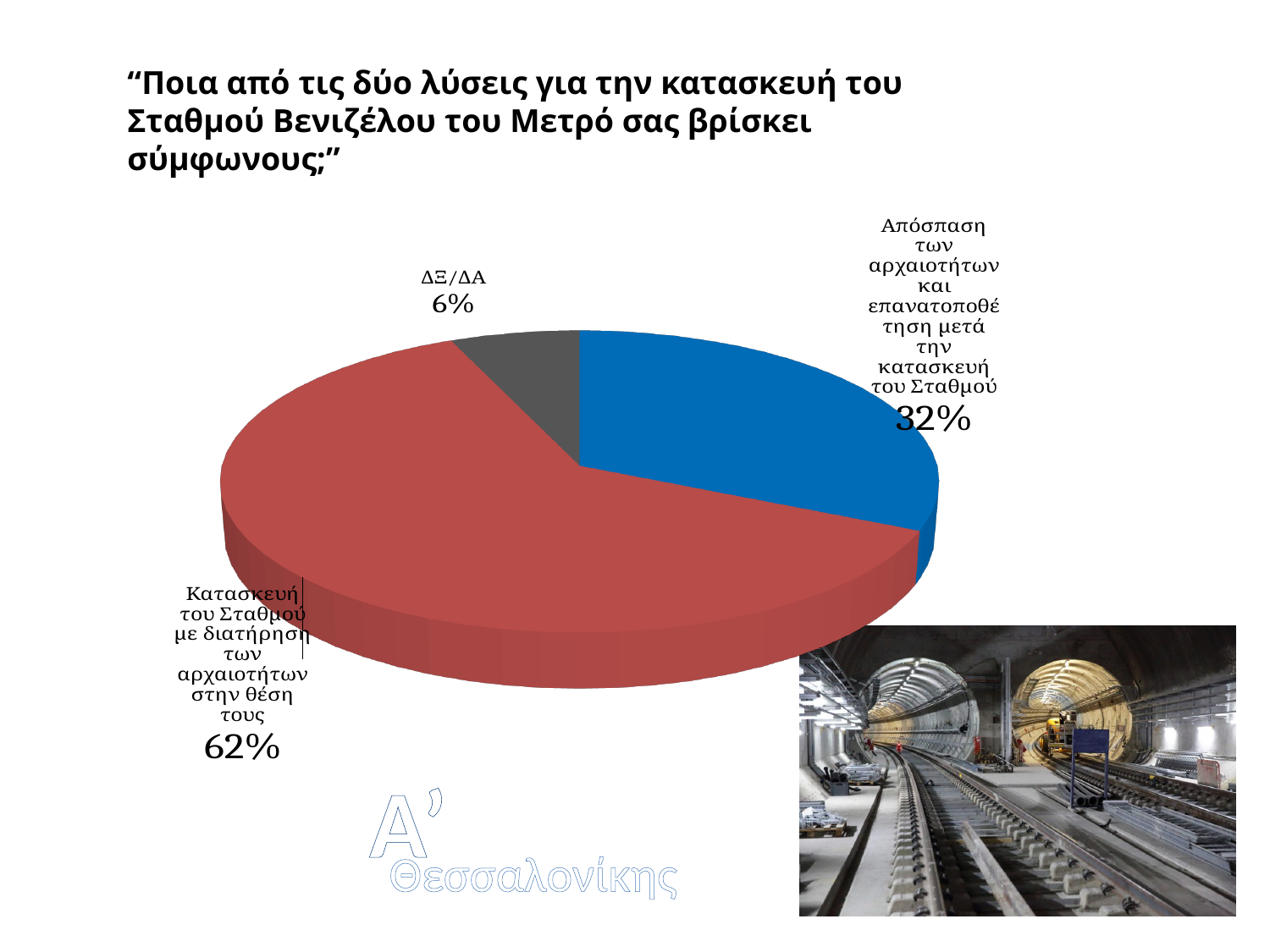
What is the difference in percentage points between the "Κατασκευή του Σταθμού με διατήρηση των αρχαιοτήτων στην θέση τους" slice and the "Απόσπαση των αρχαιοτήτων και επανατοποθέτηση μετά την κατασκευή του Σταθμού" slice? 30 Which slice of the pie chart is the smallest? ΔΞ/ΔΑ What kind of chart is shown on the slide? Pie chart What share of the pie is labelled "Κατασκευή του Σταθμού με διατήρηση των αρχαιοτήτων στην θέση τους"? 62% Which slice of the pie chart is the largest? Κατασκευή του Σταθμού με διατήρηση των αρχαιοτήτων στην θέση τους What colour is the "ΔΞ/ΔΑ" slice? Grey What share of the pie is labelled "Απόσπαση των αρχαιοτήτων και επανατοποθέτηση μετά την κατασκευή του Σταθμού"? 32% How many slices does the pie chart have? 3 What is the difference in percentage points between the "Απόσπαση των αρχαιοτήτων" slice and the "ΔΞ/ΔΑ" slice? 26 Which is larger: the "Απόσπαση των αρχαιοτήτων" slice or the "ΔΞ/ΔΑ" slice? Απόσπαση των αρχαιοτήτων What percentage is shown for the "ΔΞ/ΔΑ" slice? 6% What colour is the slice representing "Κατασκευή του Σταθμού με διατήρηση των αρχαιοτήτων στην θέση τους"? Red